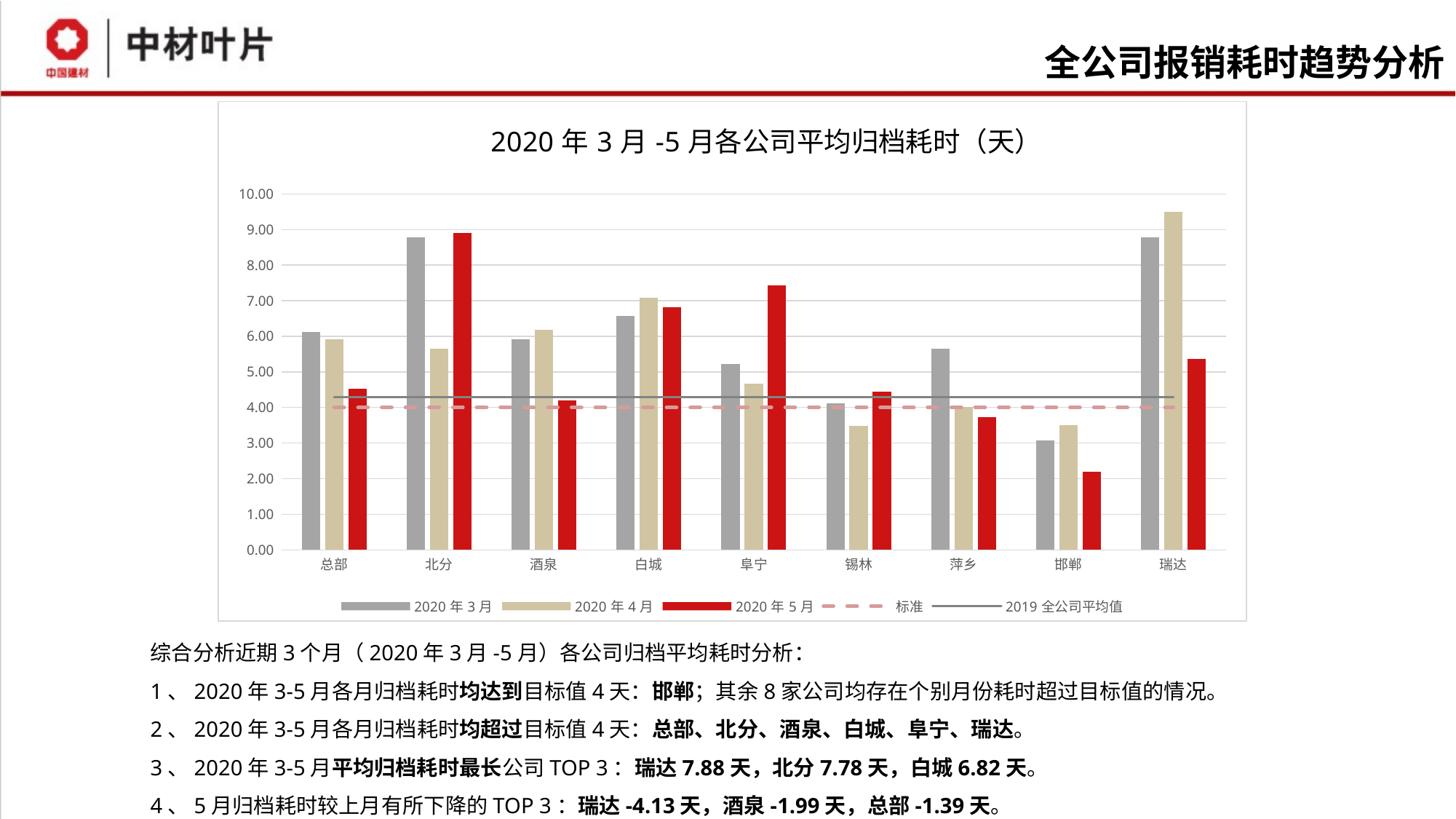
For 瑞达, which is larger: the 2020年4月 value or the 2020年5月 value? 2020年4月 Is the 2020年4月 value for 瑞达 greater or less than 9.00? greater Which company has the lowest value for 2020年5月? 邯郸 For 阜宁, which is larger: the 2020年3月 value or the 2020年5月 value? 2020年5月 How many entries does the chart legend list? 5 Which company has the highest value for 2020年5月? 北分 Which company has the highest value for 2020年4月? 瑞达 How many companies (categories) are shown on the x axis of the chart? 9 Which company has the lowest value for 2020年3月? 邯郸 What is the title of the chart? 2020年3月-5月各公司平均归档耗时（天） Is the 2020年5月 value for 邯郸 greater or less than 3.00? less What type of chart is shown on the slide? Combination bar and line chart